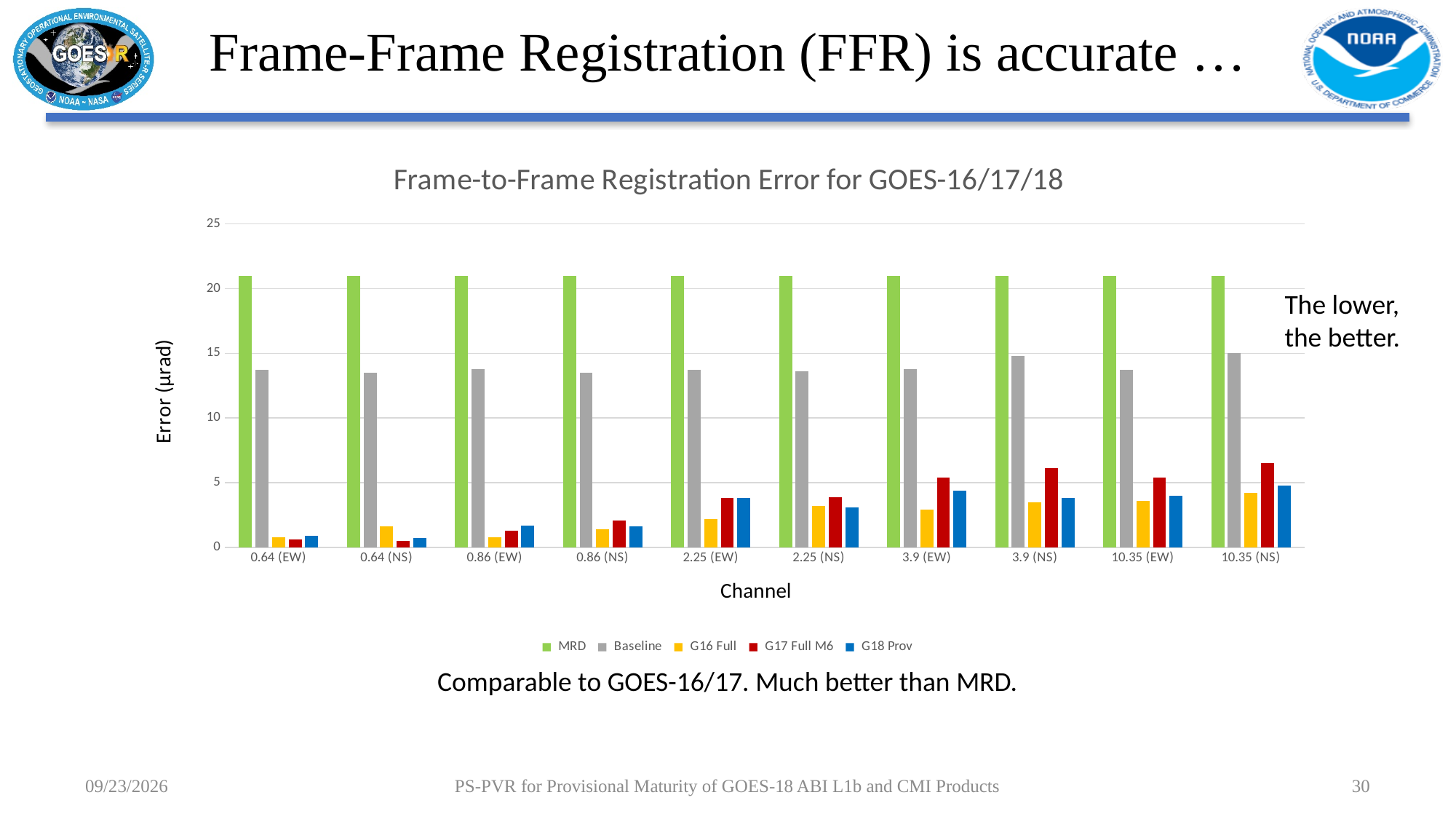
How many channel categories are shown on the x axis? 10 How many series does the legend list? 5 Is the G18 Prov value for 0.64 (EW) greater or less than 5? less What is the title of the chart? Frame-to-Frame Registration Error for GOES-16/17/18 Is the Baseline value for 3.9 (NS) greater or less than 10? greater Is the MRD value for 0.64 (EW) greater or less than 20? greater What kind of chart is shown on the slide? bar chart Which series has the highest value for the 0.64 (EW) channel? MRD What is the label of the y axis? Error (μrad) For the G17 Full M6 series, which is larger, the value for 3.9 (NS) or the value for 0.64 (NS)? 3.9 (NS) Which is larger for the 2.25 (EW) channel, the Baseline value or the G18 Prov value? Baseline